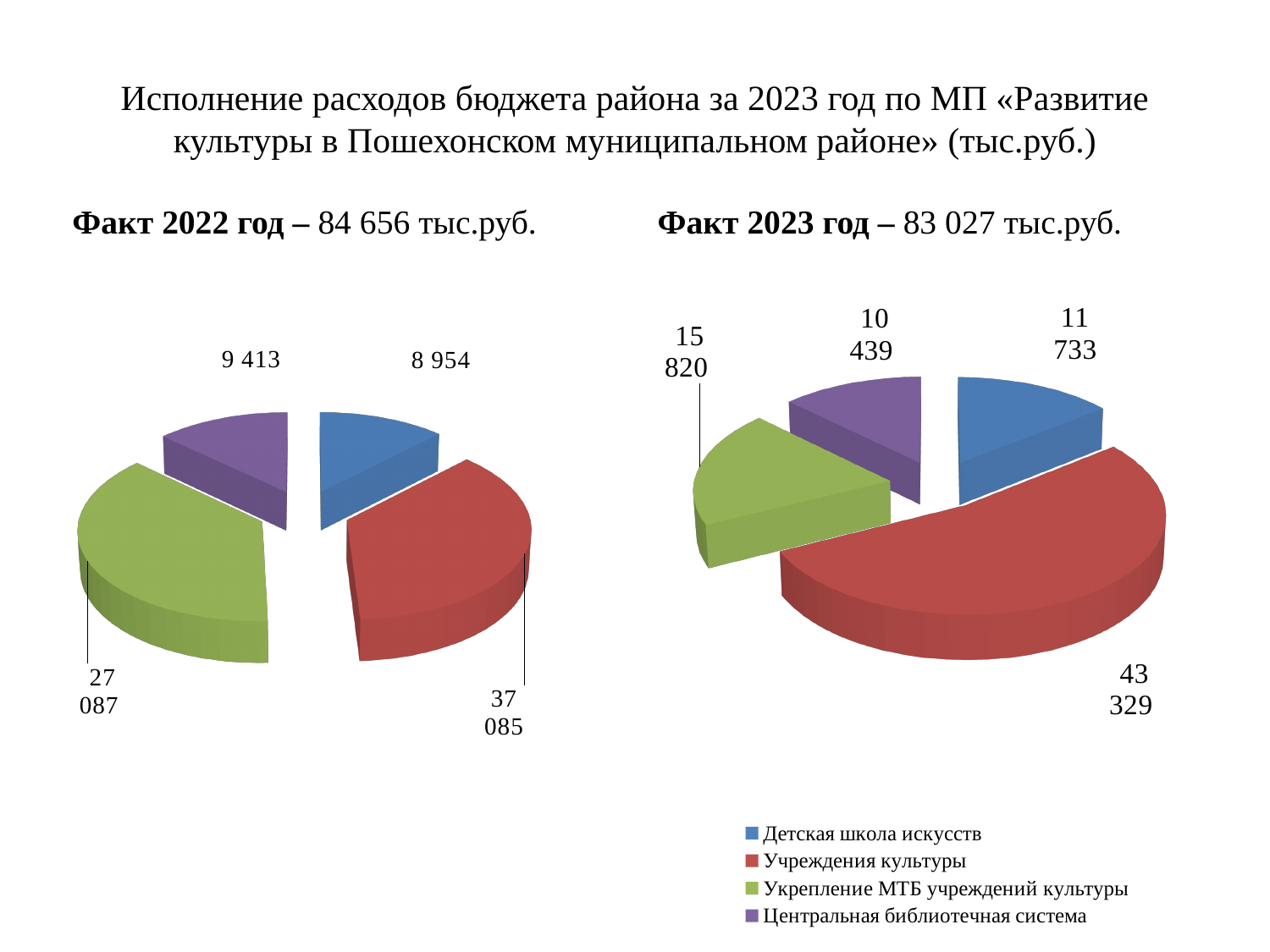
In the right pie chart (Факт 2023 год), which is larger: Укрепление МТБ учреждений культуры or Центральная библиотечная система? Укрепление МТБ учреждений культуры In the left pie chart (Факт 2022 год), what is the value of the green slice (Укрепление МТБ учреждений культуры)? 27 087 In the right pie chart (Факт 2023 год), which category has the largest slice? Учреждения культуры What is the difference between the value for Учреждения культуры in the right chart (2023) and in the left chart (2022)? 6 244 In the left pie chart (Факт 2022 год), what is the difference between the red slice (Учреждения культуры) and the green slice (Укрепление МТБ учреждений культуры)? 9 998 In the left pie chart (Факт 2022 год), what is the value of the red slice (Учреждения культуры)? 37 085 In the right pie chart (Факт 2023 год), what is the value of the blue slice (Детская школа искусств)? 11 733 In the left pie chart (Факт 2022 год), which category has the smallest slice? Детская школа искусств In the right pie chart (Факт 2023 год), what is the value of the purple slice (Центральная библиотечная система)? 10 439 How many slices does each pie chart have? 4 Which category does the green colour represent in the legend? Укрепление МТБ учреждений культуры What type of charts are shown on the slide? Pie charts